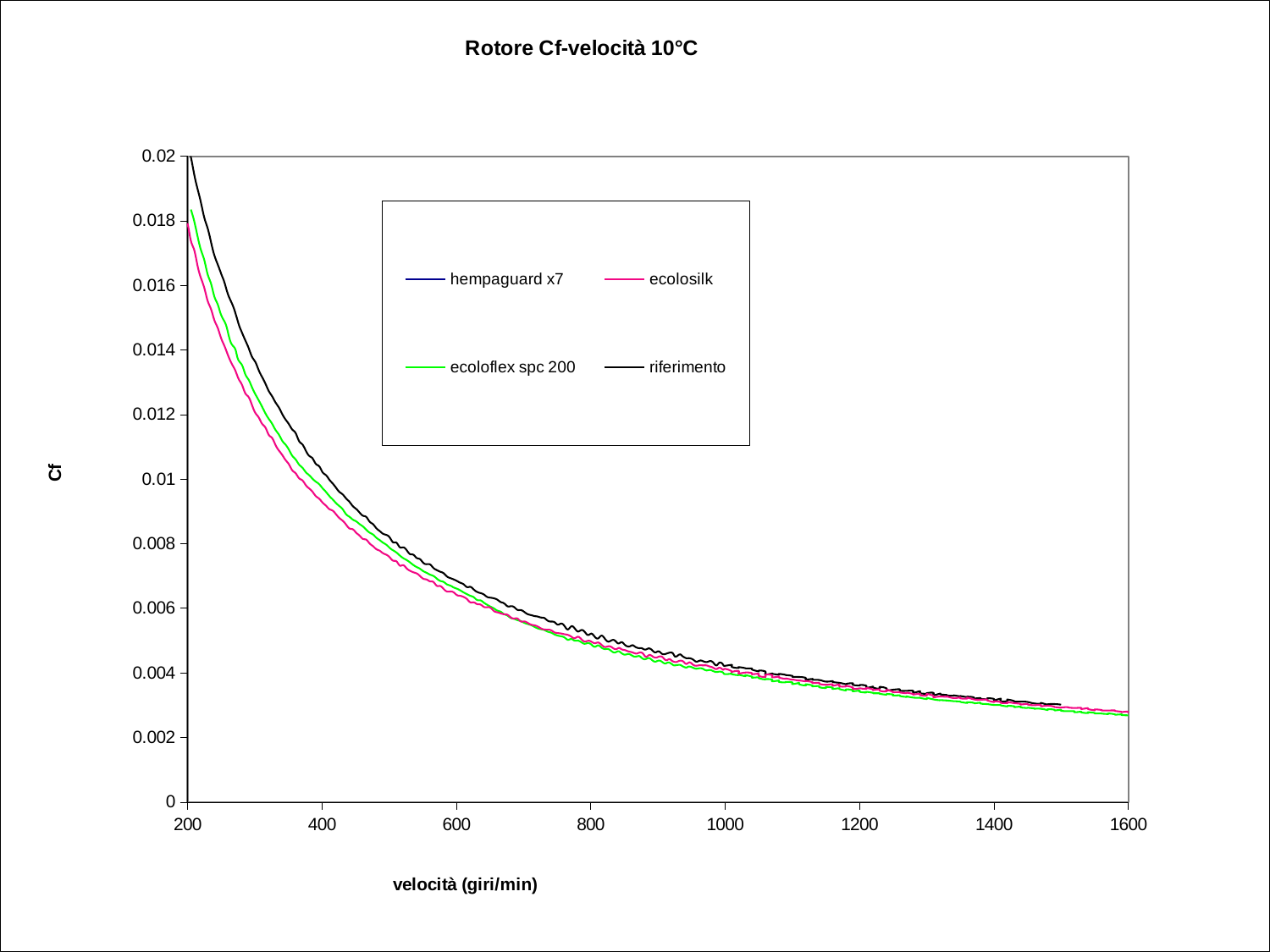
What is the label of the x axis? velocità (giri/min) What kind of chart is shown on the slide? line chart Is the Cf value for riferimento at velocità 1000 greater or less than 0.006? less How many series does the legend list? 4 What is the title of the chart? Rotore Cf-velocità 10°C Which series has the highest Cf value at velocità 200? riferimento Do the Cf values rise or fall as velocità increases along the x axis? fall Is the Cf value for riferimento at velocità 300 greater or less than 0.01? greater What is the highest value shown on the y axis? 0.02 At velocità 400, which series has the larger Cf value, riferimento or ecolosilk? riferimento Is the Cf value for ecoloflex spc 200 at velocità 1400 greater or less than 0.004? less